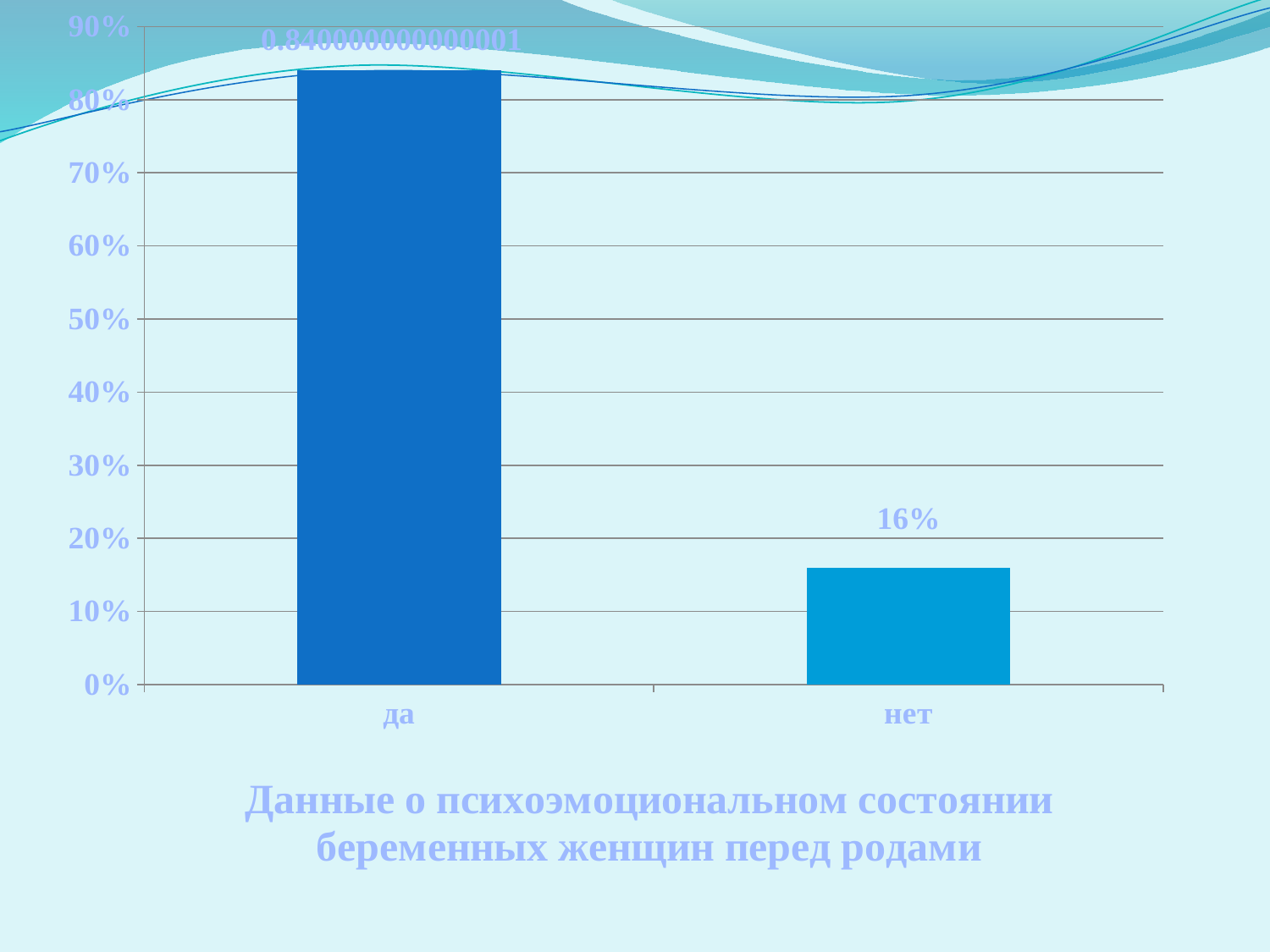
What is the value shown for the category "нет"? 16% Which is larger, the value for "да" or the value for "нет"? да How many categories are shown on the x axis? 2 Which category has the lowest bar? нет What data label is printed above the bar for "да"? 0.840000000000001 Is the value for "нет" greater or less than 20%? less What kind of chart is shown on the slide? bar chart Is the value for "да" greater or less than 80%? greater What is the highest tick value shown on the y axis? 90% Which category has the highest bar? да What is the title of the chart? Данные о психоэмоциональном состоянии беременных женщин перед родами Is the value for "да" greater or less than 90%? less